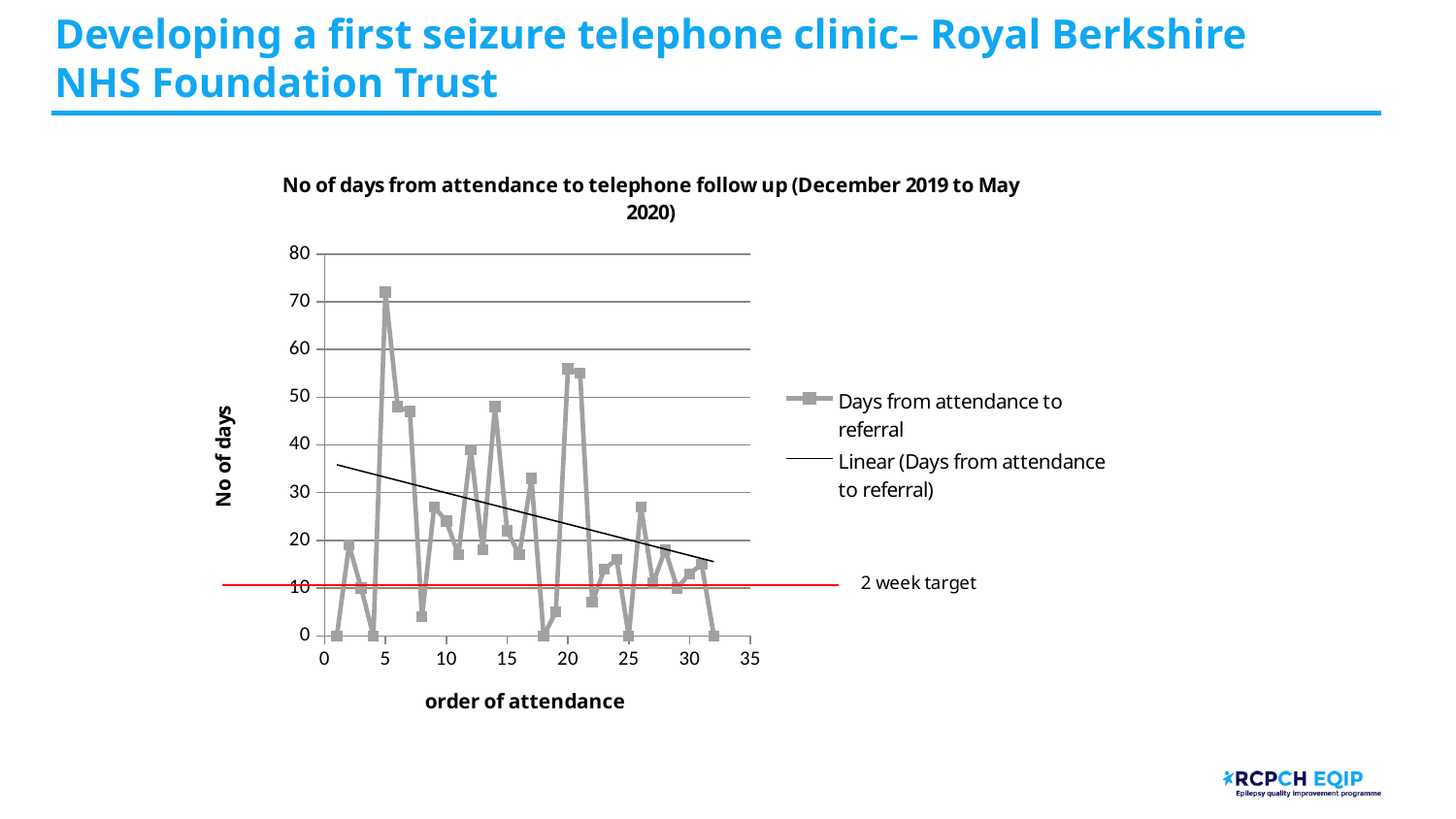
What is the label of the vertical axis? No of days How many series does the chart legend list? 2 Is the value for order of attendance 32 greater or less than 10? less What kind of chart is shown on the slide? line chart Is the value for order of attendance 14 greater or less than 40? greater Is the value for order of attendance 20 greater or less than 50? greater At which order of attendance is the number of days from attendance to referral highest? 5 What does the red horizontal line on the chart represent? 2 week target Which is larger, the value at order of attendance 5 or the value at order of attendance 20? order of attendance 5 Does the linear trend line rise or fall as the order of attendance increases? fall